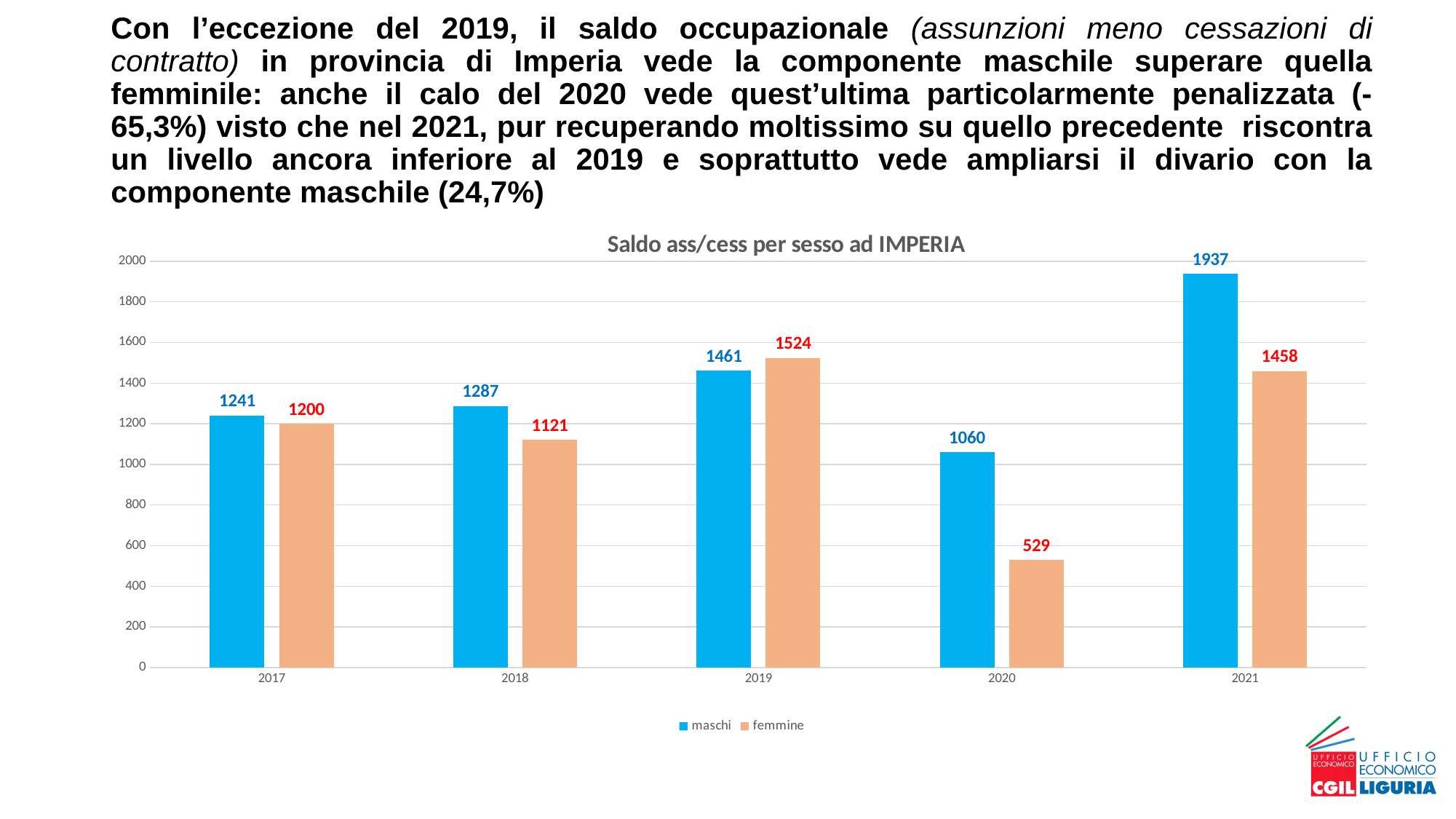
What is the difference between maschi and femmine in 2021? 479 Which year has the lowest value for femmine? 2020 What is the difference between maschi and femmine in 2020? 531 What is the value for femmine in 2020? 529 What is the title of the chart? Saldo ass/cess per sesso ad IMPERIA How many years are shown on the x axis? 5 What kind of chart is shown? bar chart Which year has the highest value for maschi? 2021 How many series does the legend list? 2 What is the value for femmine in 2019? 1524 What is the value for maschi in 2021? 1937 In 2019, which is larger, maschi or femmine? femmine